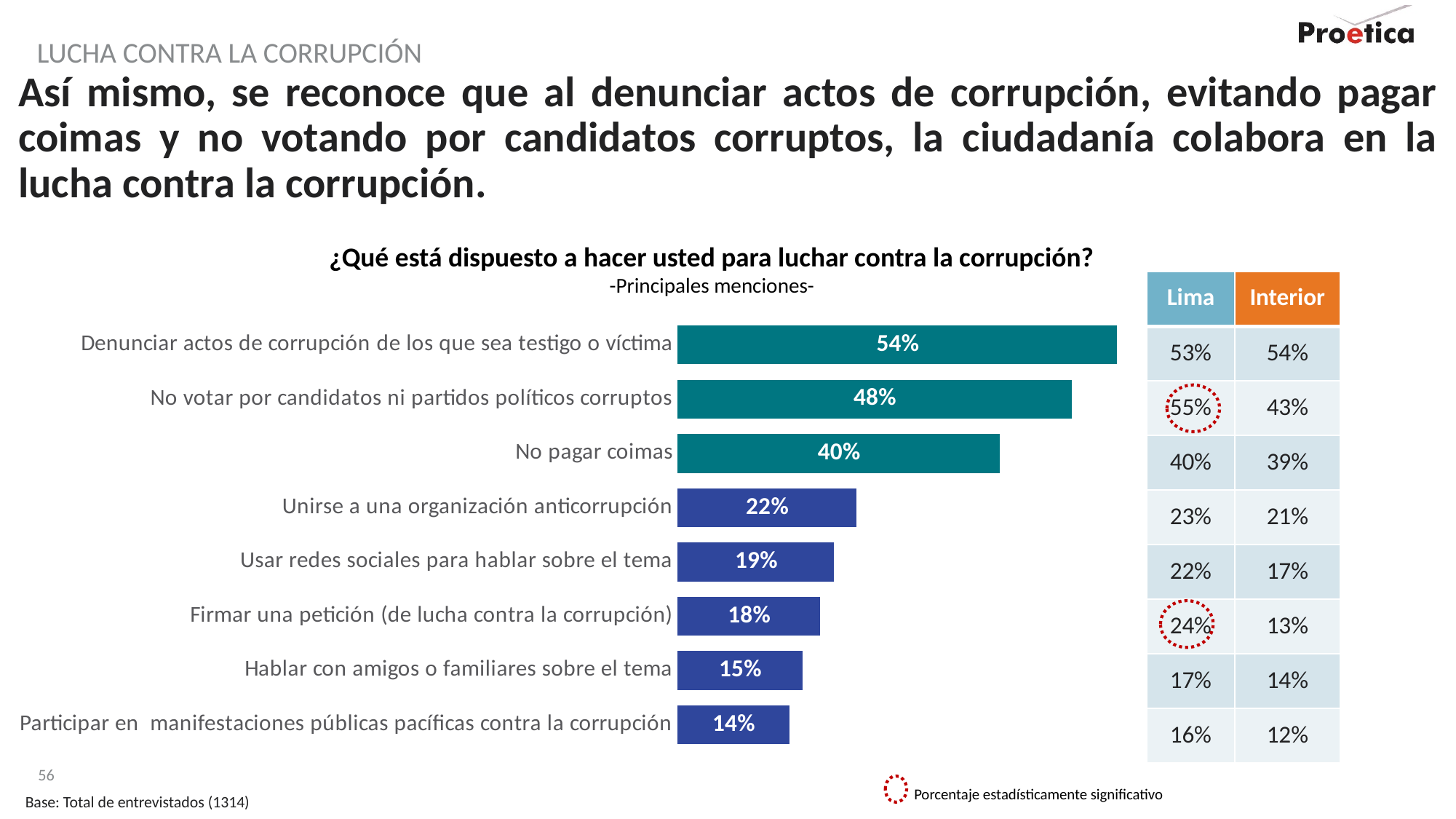
What percentage of respondents are willing to report acts of corruption they witness or are victims of (Denunciar actos de corrupción de los que sea testigo o víctima)? 54% In the table to the right of the chart, what is the Interior value for 'Firmar una petición (de lucha contra la corrupción)'? 13% What is the difference between the values for 'No votar por candidatos ni partidos políticos corruptos' and 'No pagar coimas'? 8% What is the title of the chart? ¿Qué está dispuesto a hacer usted para luchar contra la corrupción? What is the value shown for 'Usar redes sociales para hablar sobre el tema'? 19% Which category has the highest value in the chart? Denunciar actos de corrupción de los que sea testigo o víctima Which category has the lowest value in the chart? Participar en manifestaciones públicas pacíficas contra la corrupción In the table to the right of the chart, what is the Lima value for 'No votar por candidatos ni partidos políticos corruptos'? 55% What is the value shown for 'No pagar coimas'? 40% What type of chart is used on this slide? Bar chart How many categories are shown in the bar chart? 8 Which is larger: the value for 'Unirse a una organización anticorrupción' or for 'Firmar una petición (de lucha contra la corrupción)'? Unirse a una organización anticorrupción